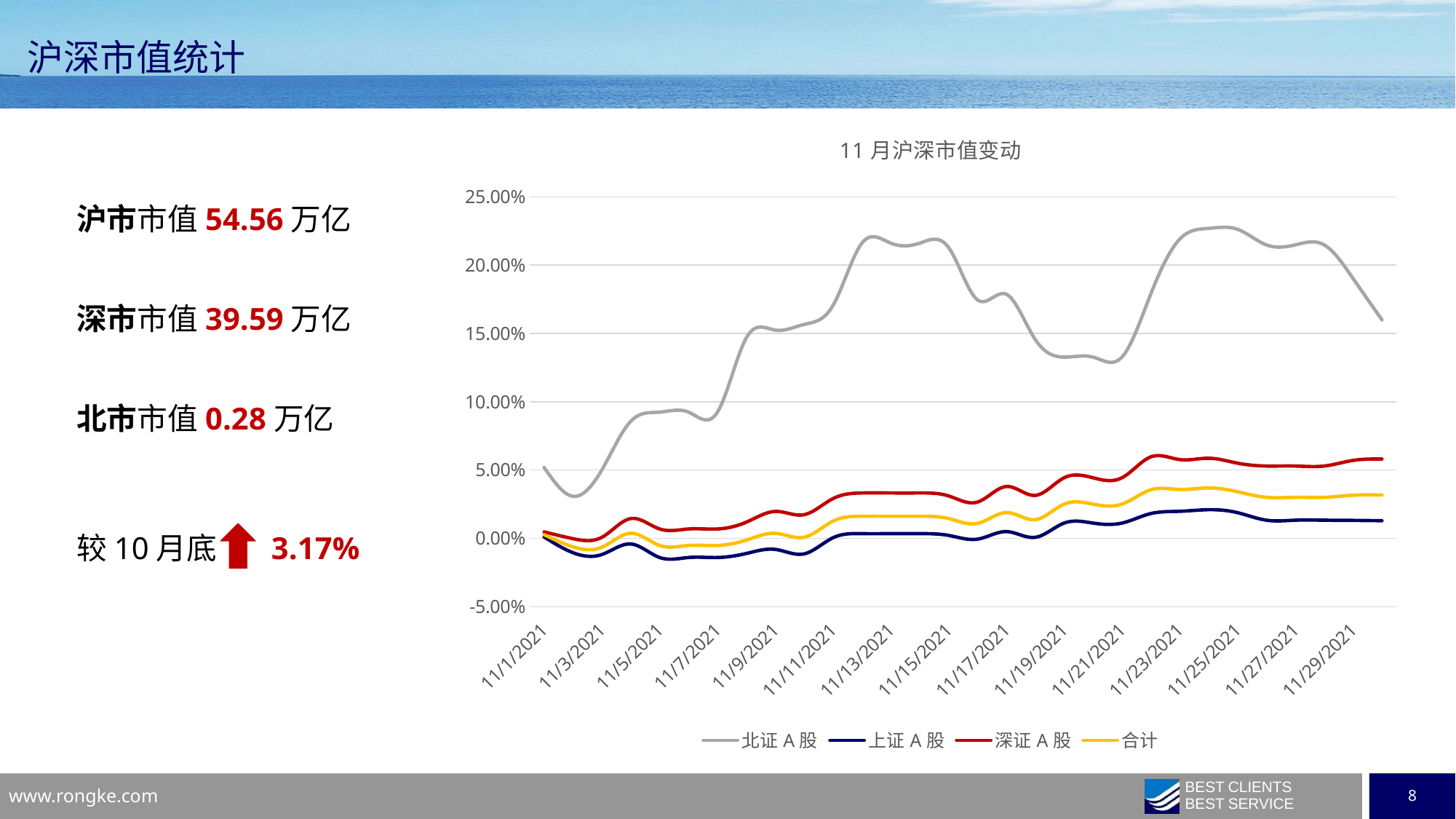
Is the value for 上证 A 股 on 11/5/2021 greater or less than 0.00%? less Which series has the highest value on 11/25/2021? 北证 A 股 What kind of chart is shown on the slide? line chart Is the value for 北证 A 股 on 11/13/2021 greater or less than 20.00%? greater How many date labels are shown on the x axis of the chart? 15 What is the title of the chart? 11 月沪深市值变动 On 11/29/2021, which series has the larger value, 深证 A 股 or 上证 A 股? 深证 A 股 How many series does the legend of the chart list? 4 Is the value for 北证 A 股 on 11/19/2021 greater or less than 15.00%? less Does the 北证 A 股 line rise or fall between 11/25/2021 and 11/29/2021? fall Which colour is used for the 深证 A 股 line in the chart? red